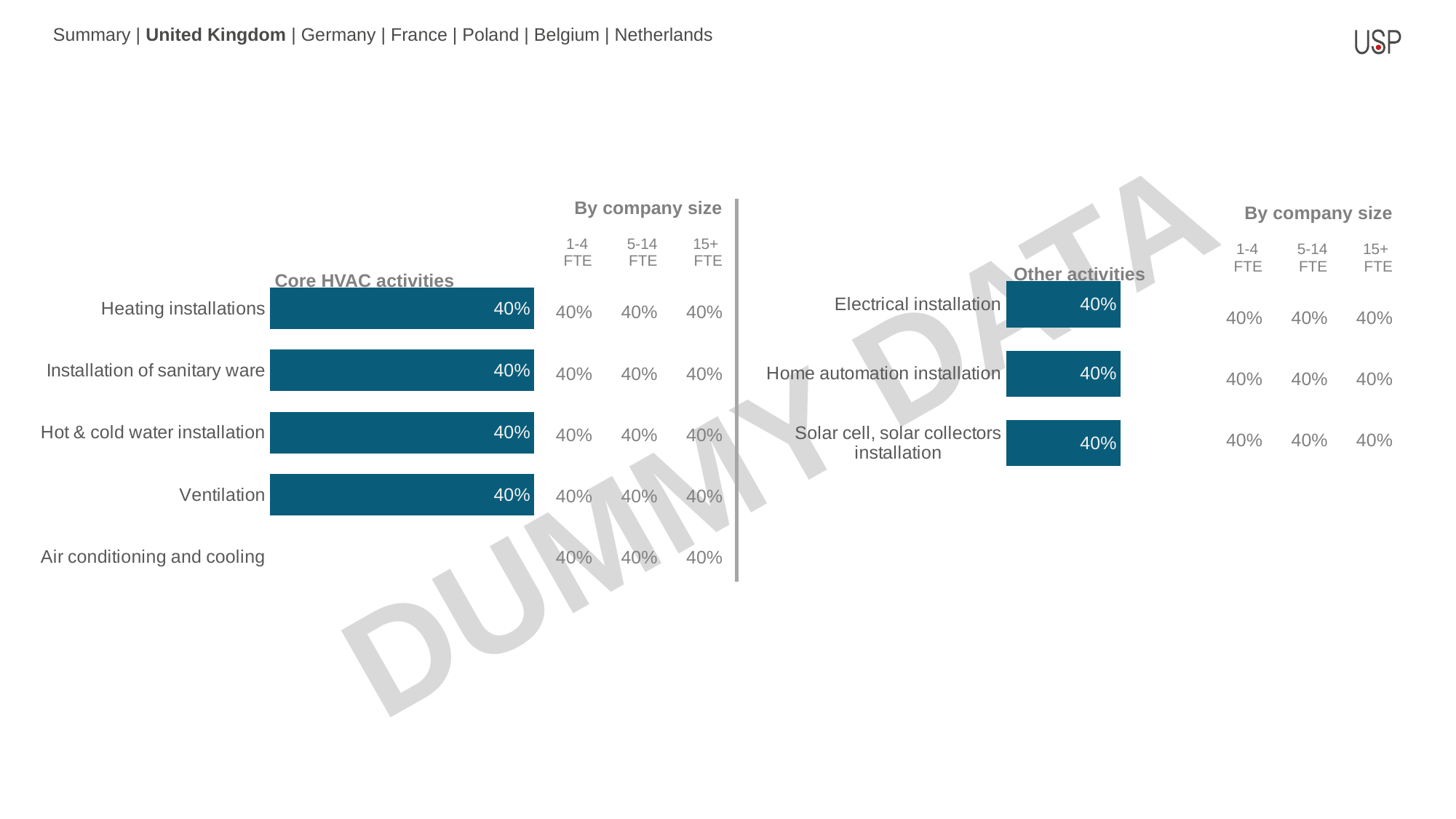
In the Core HVAC activities chart, what is the value for Heating installations? 40% In the Core HVAC activities chart, what is the value for Ventilation? 40% How many categories are plotted in the Other activities chart? 3 In the Other activities chart, what is the value for Electrical installation? 40% In the Other activities chart, what is the value for Solar cell, solar collectors installation? 40% What is the title of the chart on the left side of the slide? Core HVAC activities In the Core HVAC activities chart, what is the value for Hot & cold water installation? 40% In the Other activities chart, what is the value for Home automation installation? 40% What colour are the bars in the Core HVAC activities chart? dark teal blue In the Core HVAC activities chart, what is the difference between the values for Heating installations and Installation of sanitary ware? 0% What kind of chart is the Other activities chart? bar chart How many bars are plotted in the Core HVAC activities chart? 4